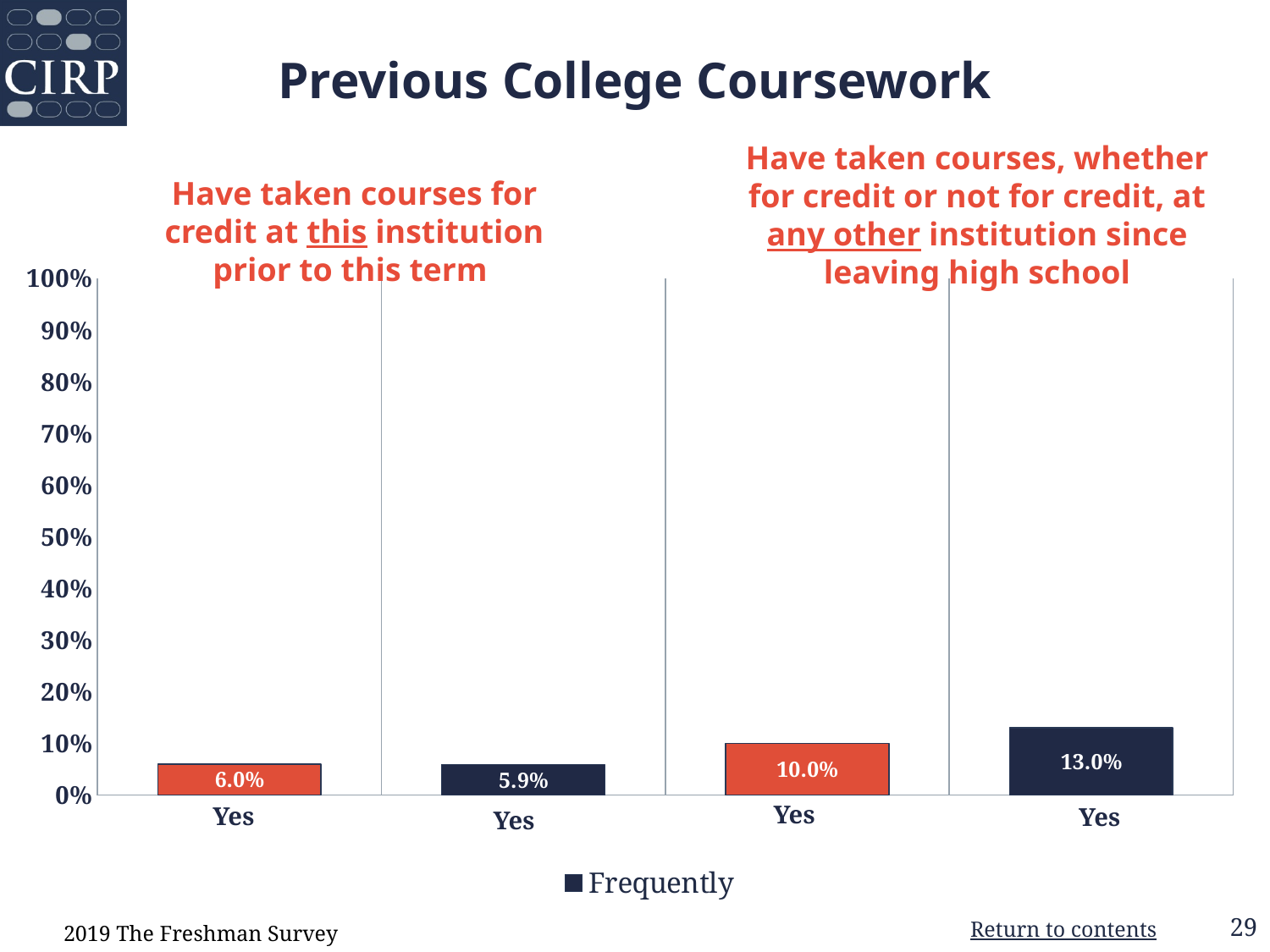
Under the "any other institution" heading, which bar is larger, the orange bar or the dark navy bar? the dark navy bar (13.0%) What is the highest value shown on any bar in the chart? 13.0% Under the heading "Have taken courses for credit at this institution prior to this term", what value is shown on the orange bar? 6.0% Is the value of the dark navy bar under "any other institution" greater or less than 20%? less What is the difference between the dark navy bar under "any other institution" (13.0%) and the dark navy bar under "this institution" (5.9%)? 7.1% What kind of chart is shown on the slide? bar chart Under the heading "Have taken courses, whether for credit or not for credit, at any other institution since leaving high school", what value is shown on the orange bar? 10.0% How many bars are plotted in the chart? 4 Under the heading "Have taken courses for credit at this institution prior to this term", what value is shown on the dark navy bar? 5.9% What is the difference between the orange bar under "any other institution" (10.0%) and the orange bar under "this institution" (6.0%)? 4.0% What is the lowest value shown on any bar in the chart? 5.9% Under the heading "Have taken courses, whether for credit or not for credit, at any other institution since leaving high school", what value is shown on the dark navy bar? 13.0%